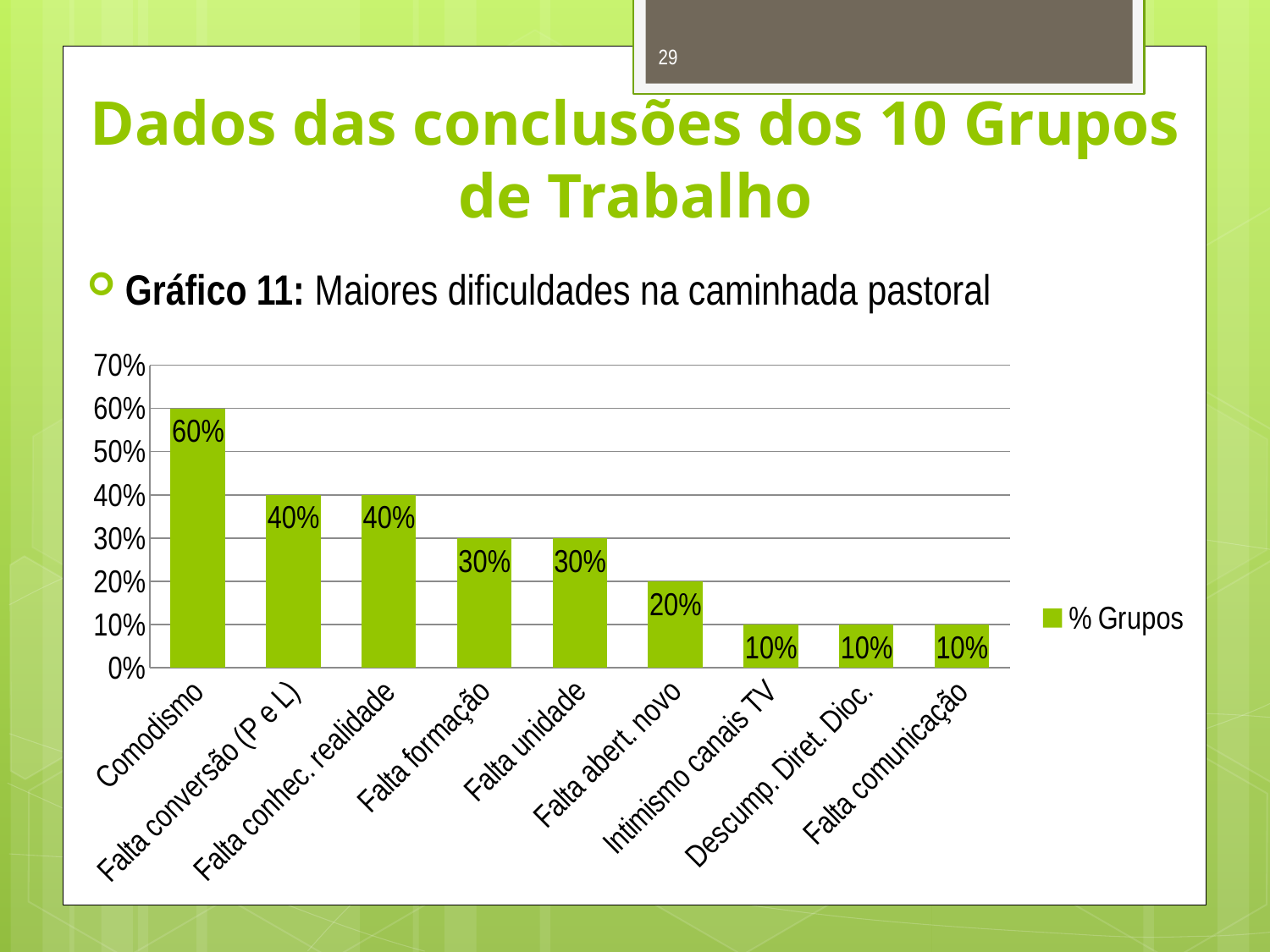
What is the value for Falta comunicação? 10% How many categories are shown on the x axis? 9 How many series does the legend list? 1 What is the value for Falta formação? 30% Which category has the highest value? Comodismo Which is larger, the value for Falta conversão (P e L) or the value for Intimismo canais TV? Falta conversão (P e L) What is the value for Comodismo? 60% What is the name of the series in the legend? % Grupos What is the value for Falta abert. novo? 20% What kind of chart is shown? Bar chart What is the difference between the values for Comodismo and Falta unidade? 30% Do the values rise or fall from left to right along the x axis? Fall